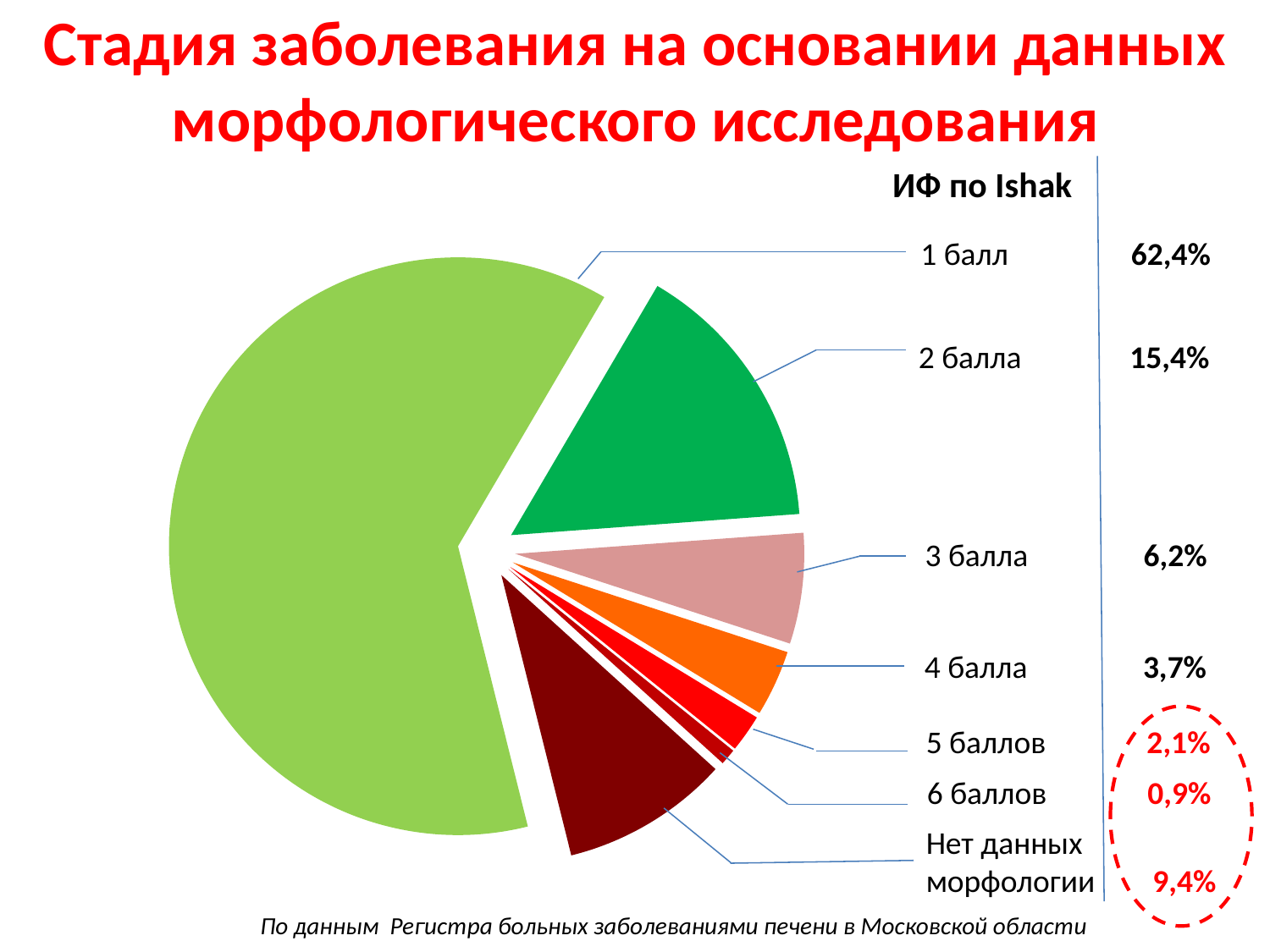
Which is larger, the value for "3 балла" or the value for "Нет данных морфологии"? Нет данных морфологии What is the difference between the values for "1 балл" and "2 балла"? 47,0% Which category has the smallest share of the pie? 6 баллов What share of the pie corresponds to "1 балл"? 62,4% What is the difference between the values for "Нет данных морфологии" and "4 балла"? 5,7% How many categories (slices) does the pie chart have? 7 What kind of chart is shown on the slide? pie chart What is the heading above the category labels on the right of the chart? ИФ по Ishak What is the value for "Нет данных морфологии"? 9,4% Which category has the largest share of the pie? 1 балл What is the value for "6 баллов"? 0,9% What is the value for "2 балла"? 15,4%